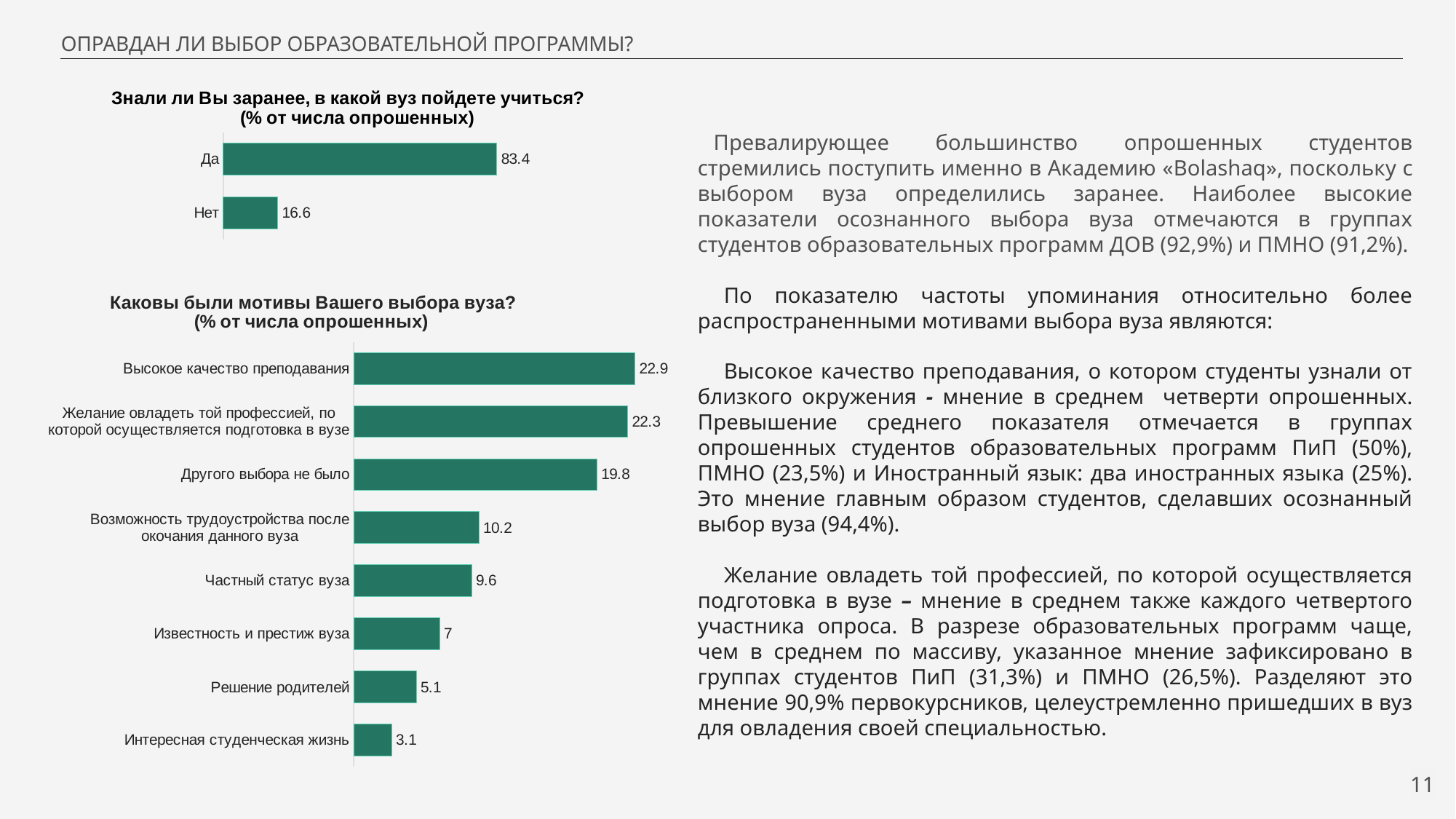
In the top chart 'Знали ли Вы заранее, в какой вуз пойдете учиться?', what is the value for 'Нет'? 16.6 What kind of chart is the bottom chart 'Каковы были мотивы Вашего выбора вуза?'? Bar chart In the bottom chart 'Каковы были мотивы Вашего выбора вуза?', what is the value for 'Другого выбора не было'? 19.8 In the bottom chart 'Каковы были мотивы Вашего выбора вуза?', which category has the lowest value? Интересная студенческая жизнь In the bottom chart 'Каковы были мотивы Вашего выбора вуза?', what is the value for 'Частный статус вуза'? 9.6 In the bottom chart 'Каковы были мотивы Вашего выбора вуза?', which category has the highest value? Высокое качество преподавания In the bottom chart 'Каковы были мотивы Вашего выбора вуза?', what is the difference between 'Высокое качество преподавания' and 'Желание овладеть той профессией, по которой осуществляется подготовка в вузе'? 0.6 In the top chart 'Знали ли Вы заранее, в какой вуз пойдете учиться?', what is the difference between the values for 'Да' and 'Нет'? 66.8 In the bottom chart 'Каковы были мотивы Вашего выбора вуза?', which is larger: 'Известность и престиж вуза' or 'Решение родителей'? Известность и престиж вуза In the top chart 'Знали ли Вы заранее, в какой вуз пойдете учиться?', what is the value for 'Да'? 83.4 In the bottom chart 'Каковы были мотивы Вашего выбора вуза?', how many categories are shown? 8 In the bottom chart 'Каковы были мотивы Вашего выбора вуза?', what is the value for 'Возможность трудоустройства после окочания данного вуза'? 10.2